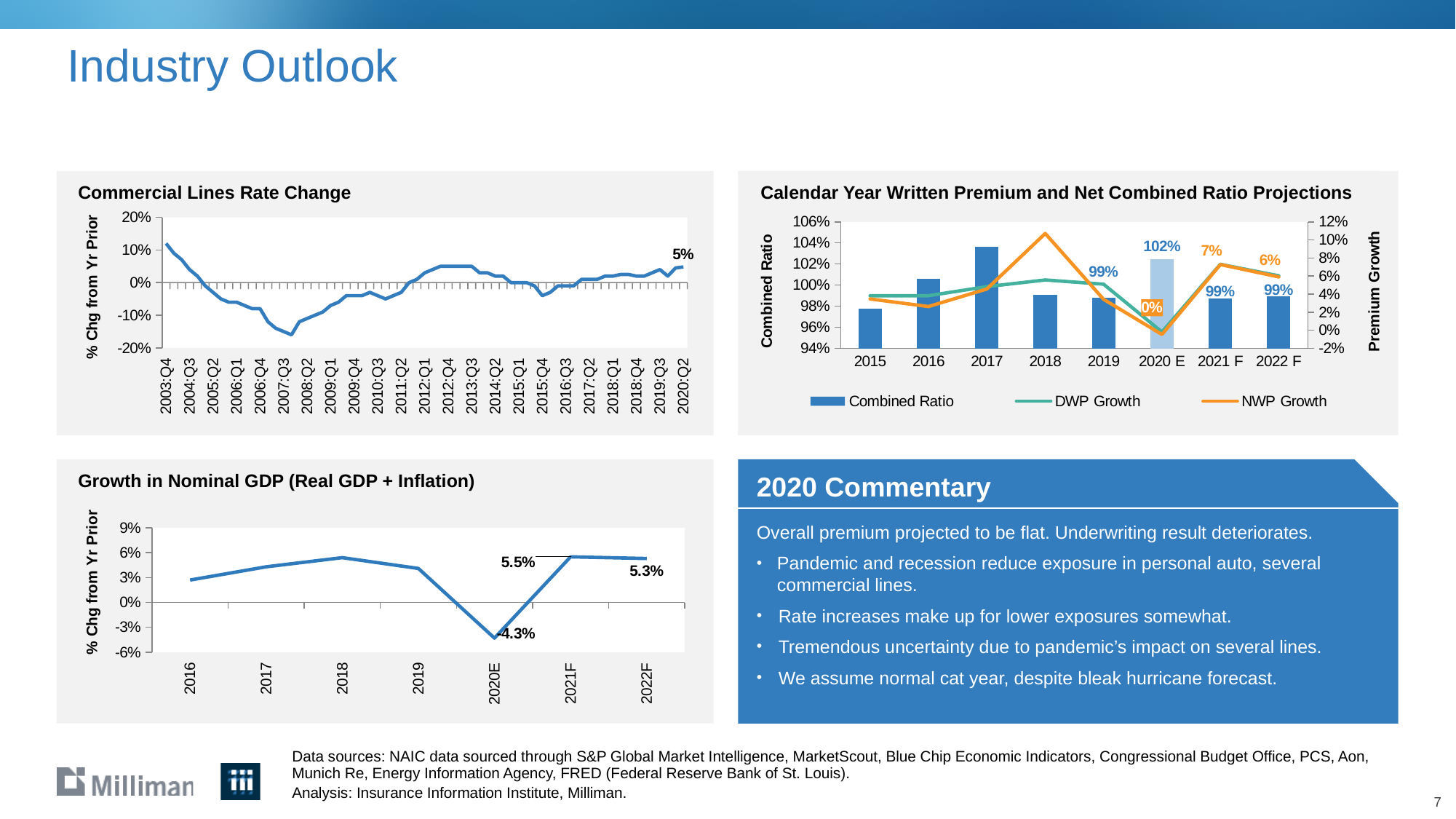
In the Commercial Lines Rate Change chart, is the value for 2007:Q3 greater or less than -10%? less In the Calendar Year Written Premium and Net Combined Ratio Projections chart, which year has the lowest Combined Ratio bar? 2015 In the Commercial Lines Rate Change chart, what is the labeled value for 2020:Q2? 5% What kind of chart is the Commercial Lines Rate Change chart? Line chart In the Calendar Year Written Premium and Net Combined Ratio Projections chart, what is the labeled NWP Growth for 2021 F? 7% In the Calendar Year Written Premium and Net Combined Ratio Projections chart, is the NWP Growth for 2018 greater or less than 8%? greater In the Calendar Year Written Premium and Net Combined Ratio Projections chart, which year has the highest Combined Ratio bar? 2017 In the Growth in Nominal GDP chart, what is the labeled value for 2020E? -4.3% In the Growth in Nominal GDP chart, which year has the lowest value? 2020E In the Calendar Year Written Premium and Net Combined Ratio Projections chart, what is the labeled Combined Ratio for 2020 E? 102% How many series does the legend of the Calendar Year Written Premium and Net Combined Ratio Projections chart list? 3 In the Growth in Nominal GDP chart, how many years are shown on the x axis? 7